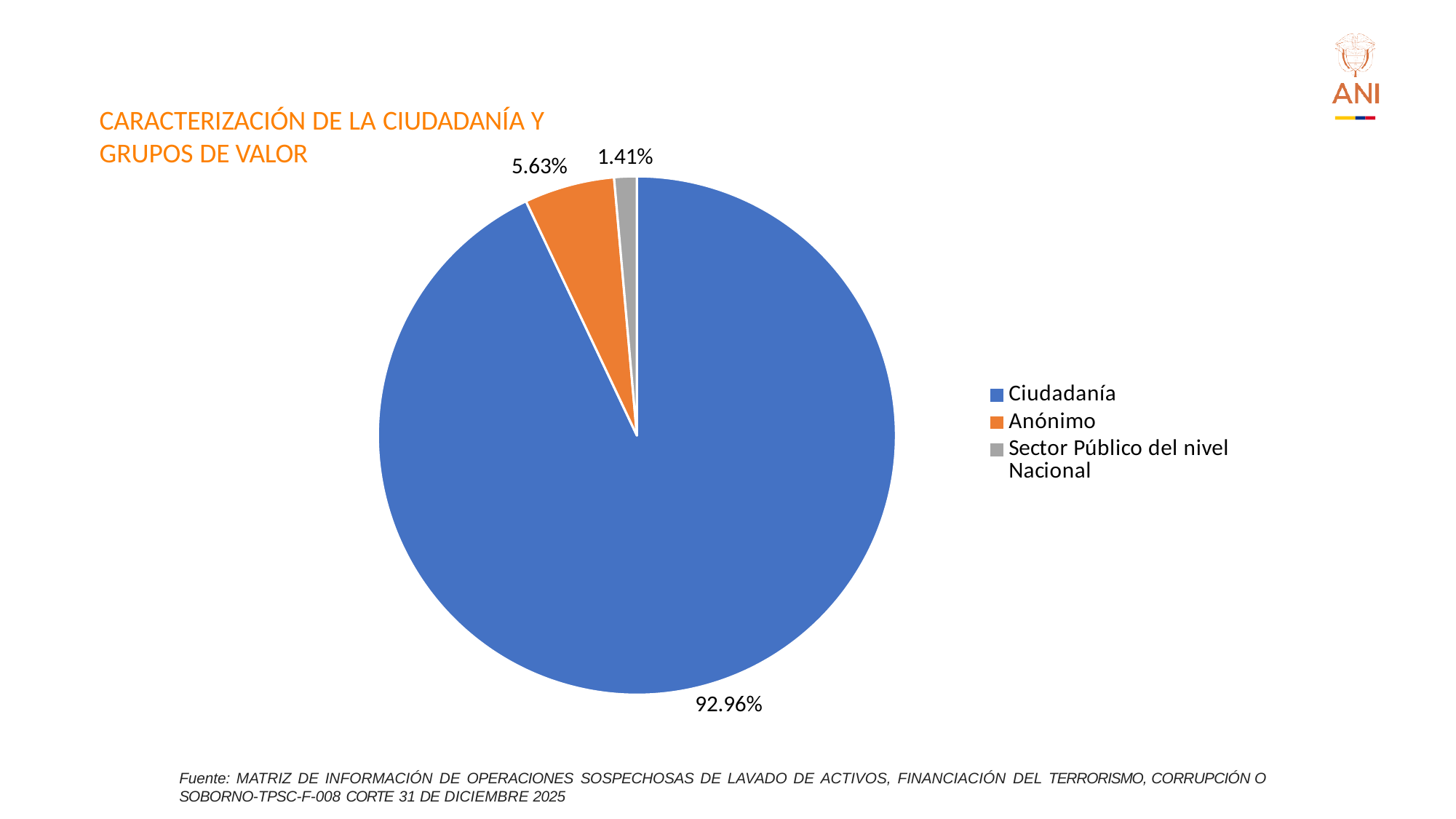
How many categories does the pie chart show? 3 Which category has the smallest slice of the pie? Sector Público del nivel Nacional Which category has the largest slice of the pie? Ciudadanía What share of the pie does Sector Público del nivel Nacional represent? 1.41% What colour is the slice for Anónimo? Orange What is the difference in percentage points between Anónimo and Sector Público del nivel Nacional? 4.22 What share of the pie does Anónimo represent? 5.63% What share of the pie does Ciudadanía represent? 92.96% What is the title shown above the chart? CARACTERIZACIÓN DE LA CIUDADANÍA Y GRUPOS DE VALOR What kind of chart is shown on the slide? Pie chart Which is larger, the share for Anónimo or the share for Sector Público del nivel Nacional? Anónimo What is the difference in percentage points between Ciudadanía and Anónimo? 87.33